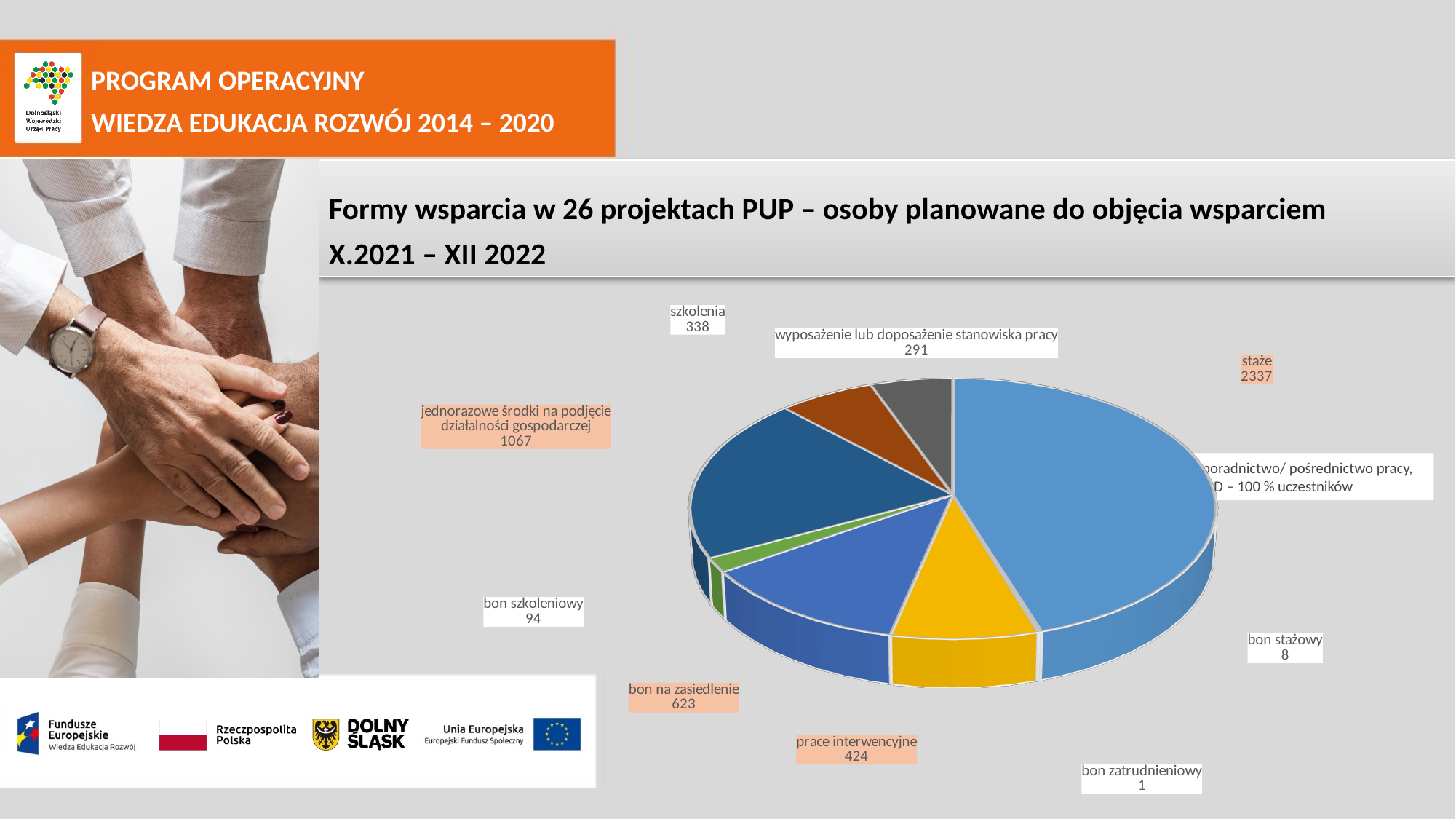
What is the difference between the values for 'bon na zasiedlenie' and 'prace interwencyjne'? 199 What kind of chart is shown on the slide? pie chart What is the difference between the values for 'staże' and 'jednorazowe środki na podjęcie działalności gospodarczej'? 1270 What is the value shown for 'bon na zasiedlenie'? 623 Which is larger, the value for 'szkolenia' or for 'wyposażenie lub doposażenie stanowiska pracy'? szkolenia What is the value shown for 'jednorazowe środki na podjęcie działalności gospodarczej'? 1067 What is the value shown for 'wyposażenie lub doposażenie stanowiska pracy'? 291 What is the title of the chart? Formy wsparcia w 26 projektach PUP – osoby planowane do objęcia wsparciem X.2021 – XII 2022 What is the value shown for 'bon stażowy'? 8 How many people are planned for 'staże'? 2337 Which form of support has the lowest value? bon zatrudnieniowy Which form of support has the highest value? staże